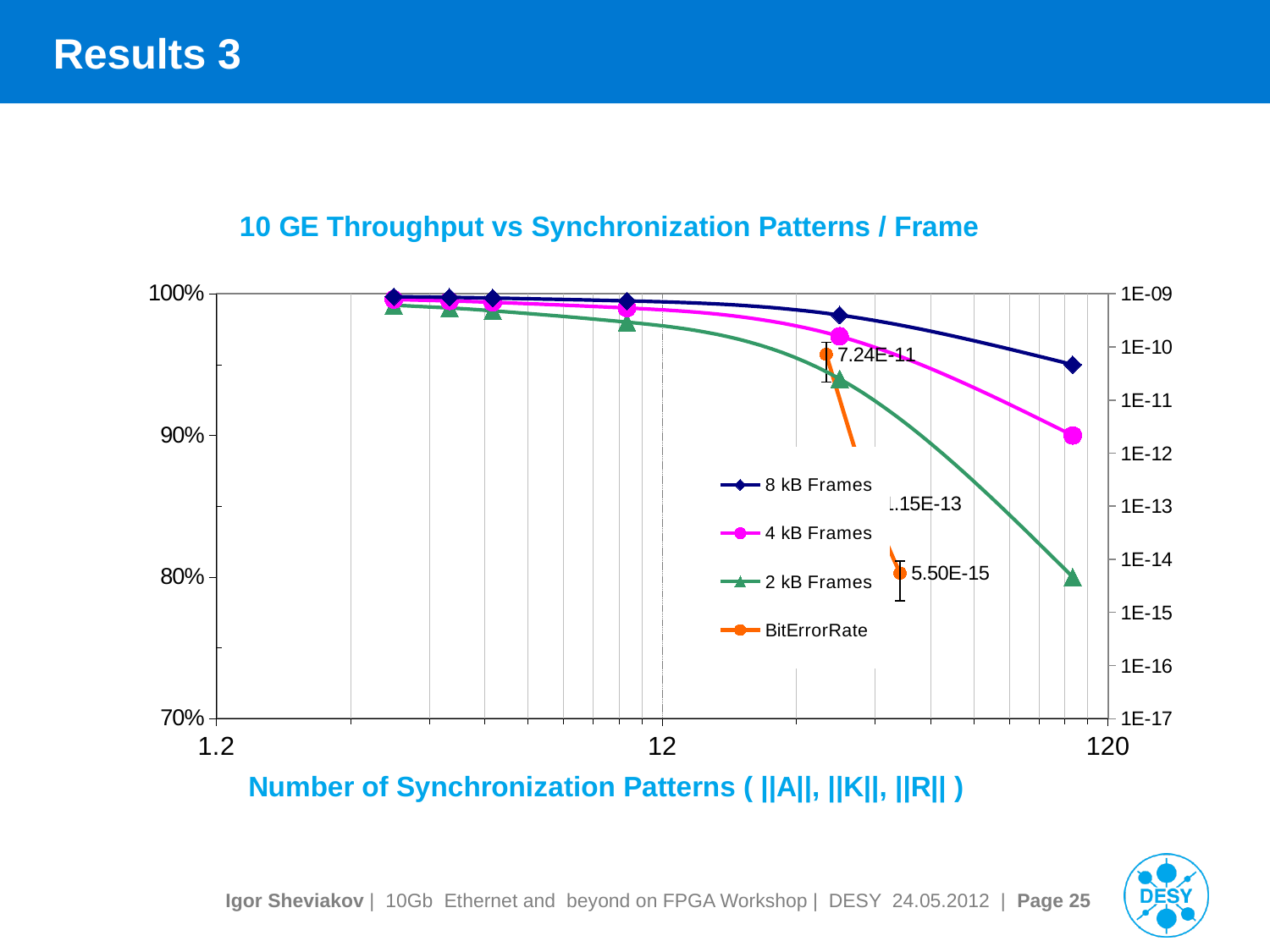
At the rightmost data point, which is larger: the throughput for 4 kB Frames or for 2 kB Frames? 4 kB Frames What is the lowest labelled value of the BitErrorRate series? 5.50E-15 What is the first labelled value of the BitErrorRate series? 7.24E-11 How many series does the legend list? 4 What kind of chart is shown on the slide? line chart How many tick labels are shown on the x axis? 3 What is the title of the chart? 10 GE Throughput vs Synchronization Patterns / Frame Does the throughput of the 2 kB Frames series rise or fall as the number of synchronization patterns increases? fall What is the label of the x axis? Number of Synchronization Patterns ( ||A||, ||K||, ||R|| ) At the rightmost data point, is the throughput for 8 kB Frames greater or less than 90%? greater Which series has the highest throughput at the rightmost data point? 8 kB Frames Which series has the lowest throughput at the rightmost data point? 2 kB Frames